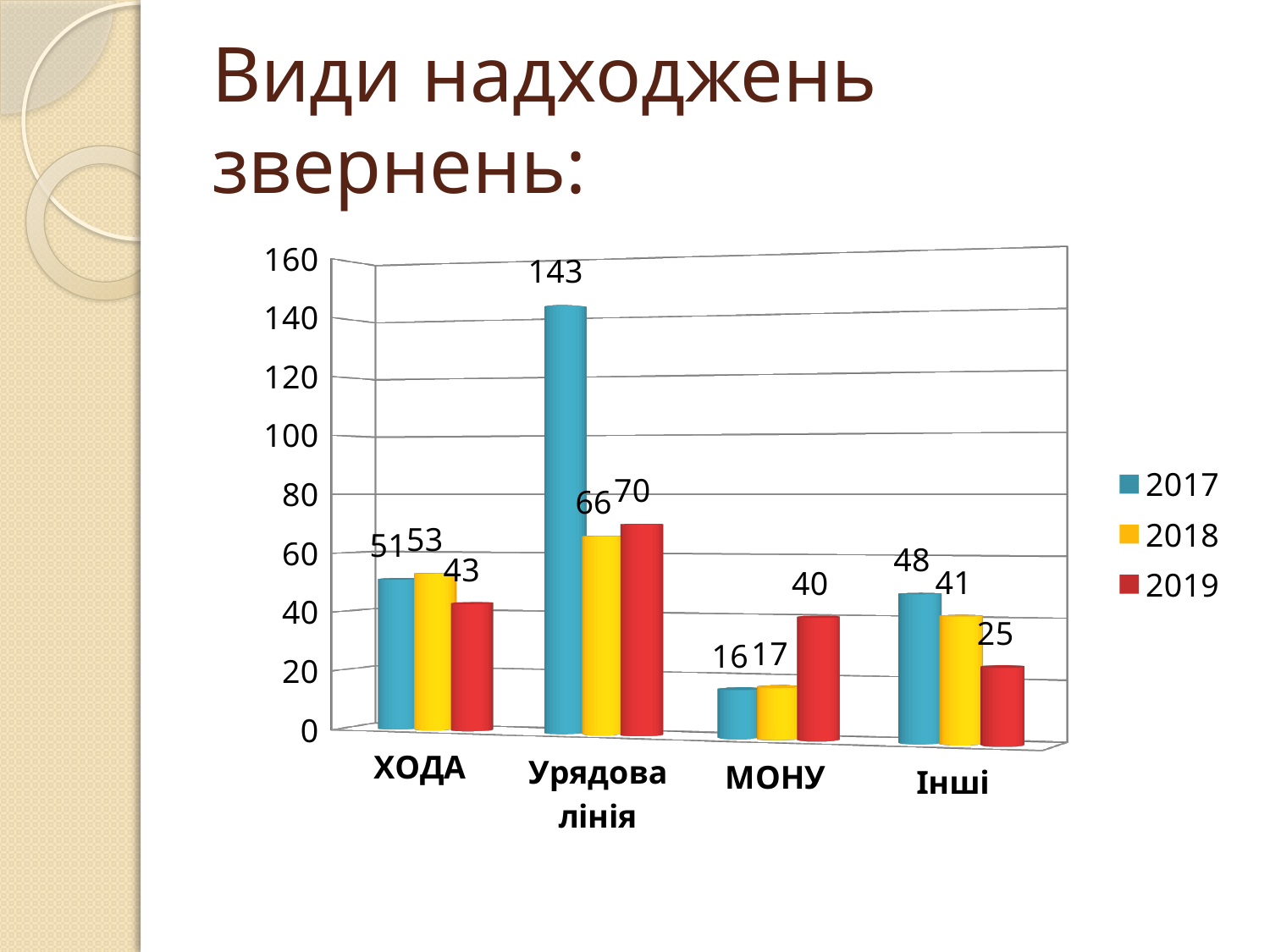
Which category has the highest value in 2017? Урядова лінія What is the value for ХОДА in 2019? 43 What is the value for МОНУ in 2019? 40 What kind of chart is shown on the slide? Bar chart How many categories are shown on the x axis? 4 What is the value for Інші in 2018? 41 How many series does the legend list? 3 What is the value for Урядова лінія in 2017? 143 What is the difference between the 2017 and 2019 values for Урядова лінія? 73 Which category has the lowest value in 2018? МОНУ Which series is shown in red in the legend? 2019 Which is larger for Інші: the 2017 value or the 2019 value? 2017